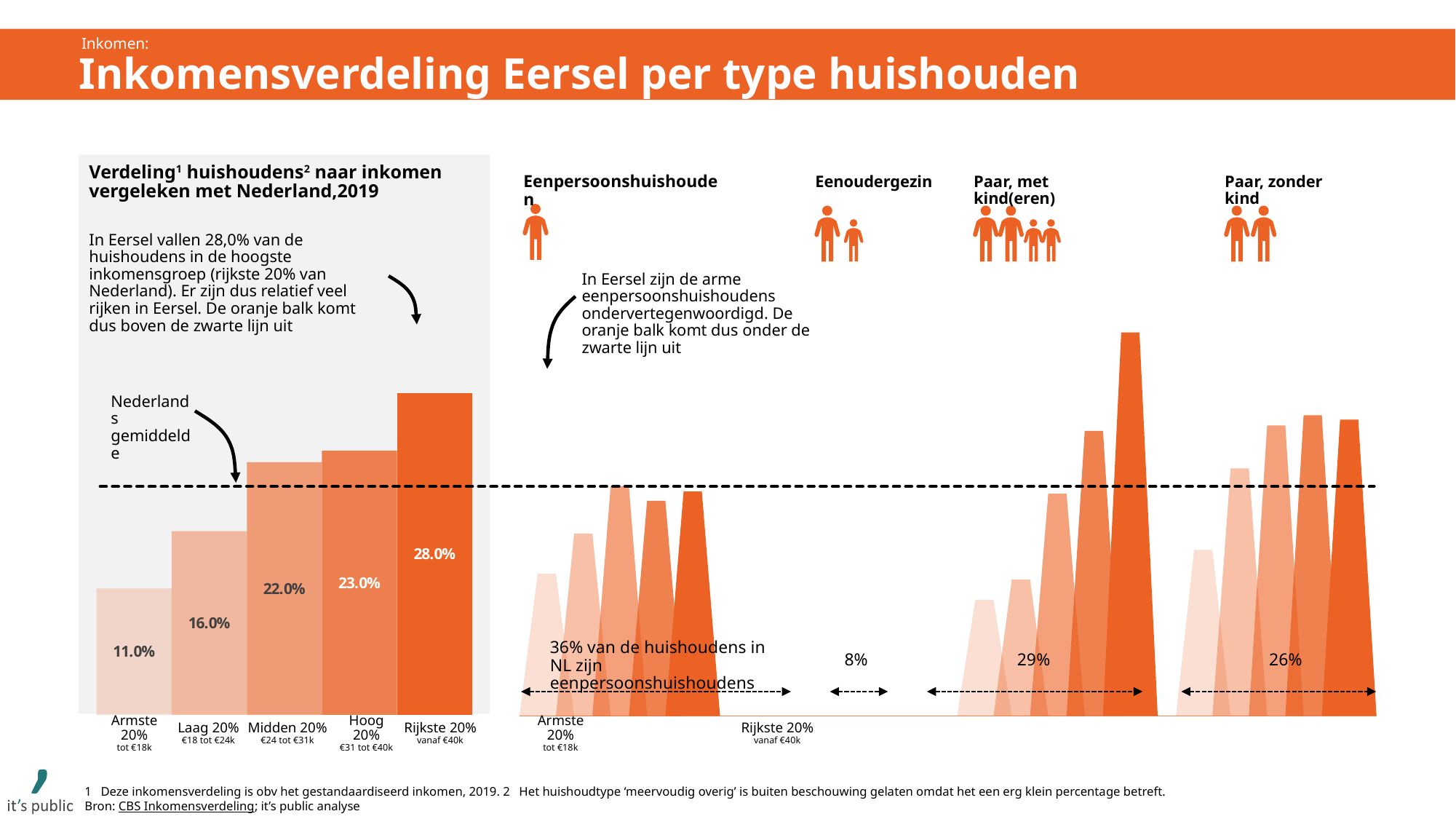
In the left chart, what is the value for Laag 20%? 16.0% In the left chart 'Verdeling huishoudens naar inkomen vergeleken met Nederland, 2019', what is the value for Rijkste 20%? 28.0% What kind of chart is the left chart? Bar chart In the left chart, what is the value for Midden 20%? 22.0% In the left chart, do the values rise or fall from Armste 20% to Rijkste 20%? Rise In the left chart, which is larger: the value for Hoog 20% or the value for Midden 20%? Hoog 20% In the left chart, what is the value for Armste 20%? 11.0% In the left chart, what is the difference between the values for Rijkste 20% and Armste 20%? 17.0% In the left chart, which income group has the lowest value? Armste 20% In the right-hand charts, what percentage of households in NL are Eenoudergezin? 8% In the left chart, which income group has the highest value? Rijkste 20% How many income groups are shown in the left chart? 5